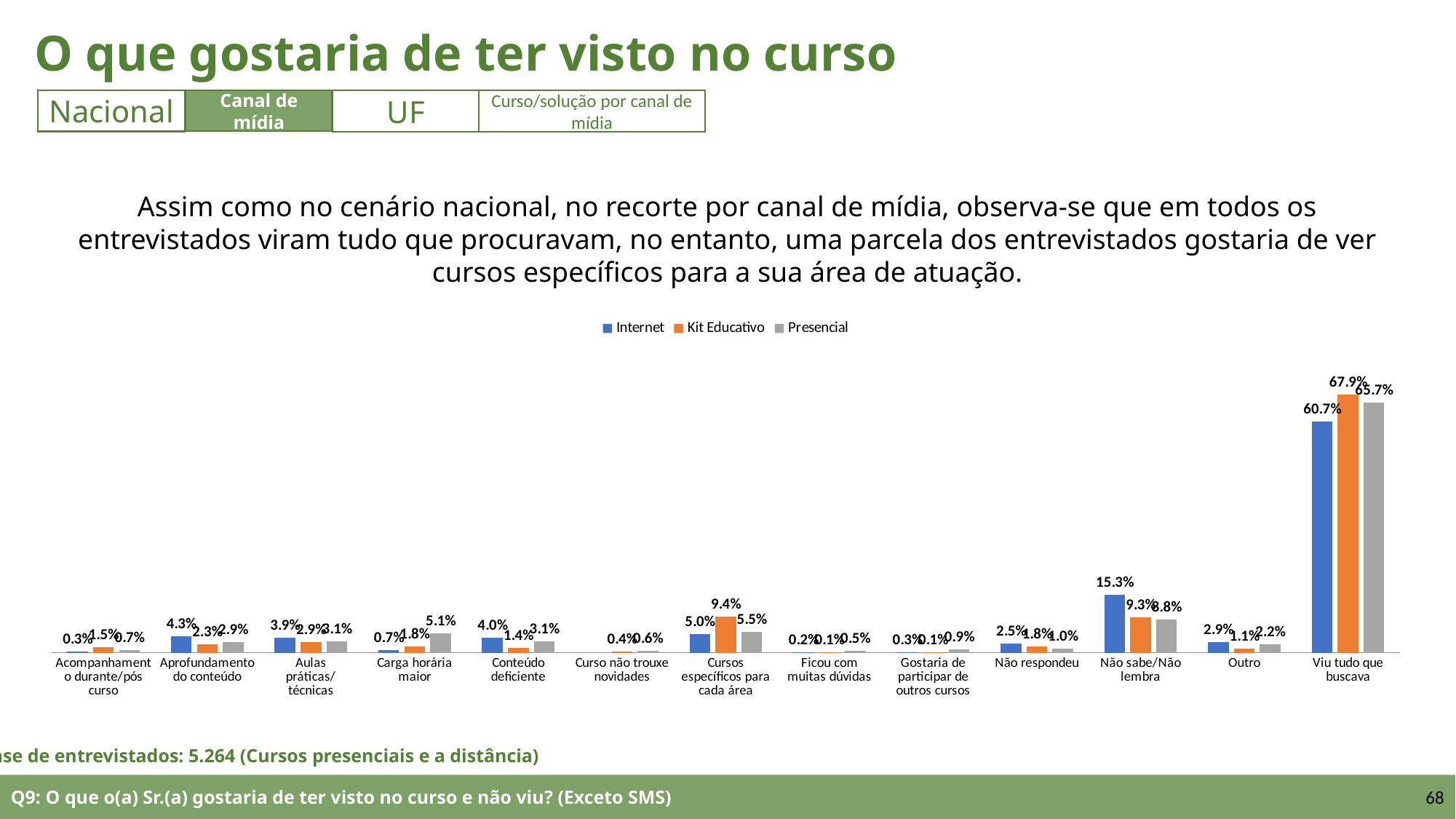
How many series does the chart legend list? 3 What is the value for Kit Educativo in the 'Viu tudo que buscava' category? 67.9% Which series has the lowest value in the 'Viu tudo que buscava' category? Internet What kind of chart is shown on the slide? Bar chart What is the value for Presencial in the 'Carga horária maior' category? 5.1% What is the value for Internet in the 'Não sabe/Não lembra' category? 15.3% What is the value for Kit Educativo in the 'Cursos específicos para cada área' category? 9.4% In the 'Aprofundamento do conteúdo' category, which is larger: Internet or Kit Educativo? Internet How many categories are shown on the x axis of the chart? 13 What is the difference between the Internet and Presencial values in the 'Não sabe/Não lembra' category? 6.5% Which category has the highest value for the Internet series? Viu tudo que buscava What is the difference between the Kit Educativo and Internet values in the 'Viu tudo que buscava' category? 7.2%